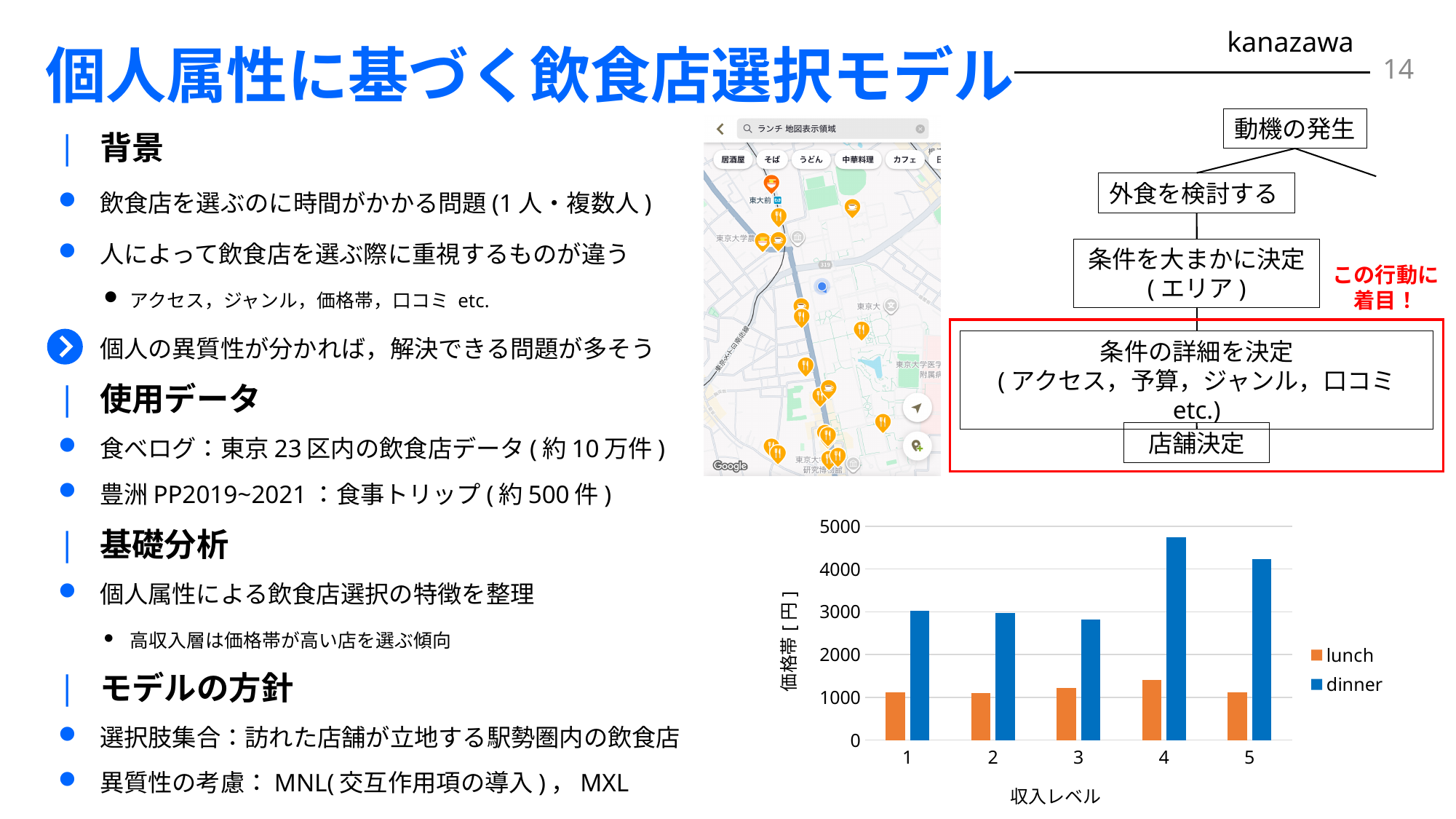
In the bar chart, is the dinner value for income level 3 greater or less than 2000? greater In the bar chart, which income level has the highest dinner value? 4 How many income levels (収入レベル) are shown on the x axis of the bar chart? 5 In the bar chart, is the dinner value for income level 4 greater or less than 4000? greater Which colour represents the dinner series in the bar chart? blue How many series does the legend of the bar chart list? 2 In the bar chart, which income level has the highest lunch value? 4 In the bar chart, is the lunch value for income level 1 greater or less than 2000? less What is the y-axis label of the bar chart? 価格帯 [円] In the bar chart, which is larger at income level 5: the lunch value or the dinner value? dinner In the bar chart, which is larger: the dinner value at income level 4 or at income level 5? income level 4 What kind of chart is shown at the bottom right of the slide? bar chart